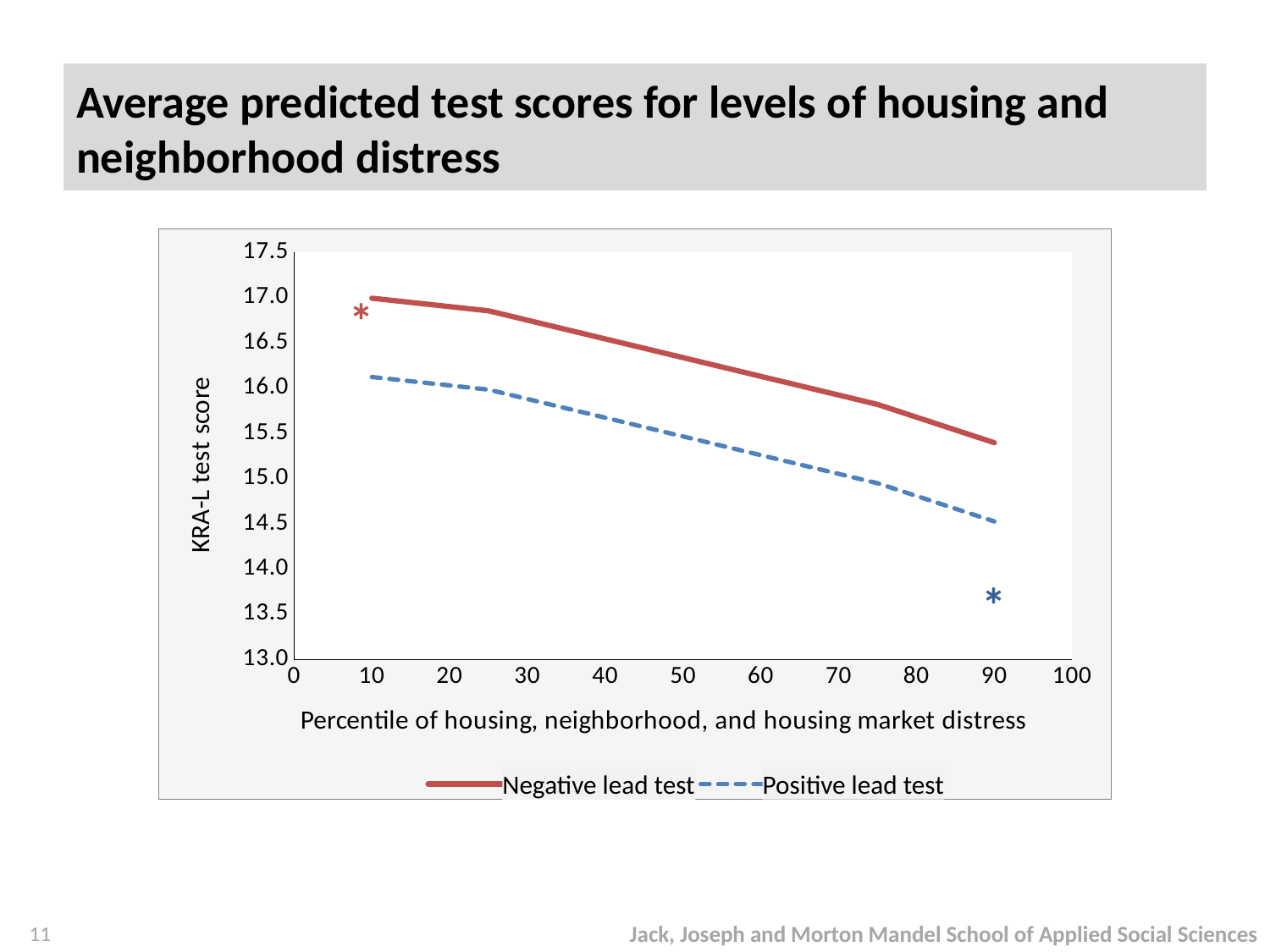
How many series does the legend list? 2 Is the value for Positive lead test at the 90th percentile greater or less than 15.0? less Do the predicted test scores rise or fall as the percentile of distress increases? fall What is the label of the y axis? KRA-L test score What kind of chart is shown on the slide? line chart Is the value for Positive lead test at the 10th percentile greater or less than 15.5? greater Is the value for Negative lead test at the 10th percentile greater or less than 16.5? greater At the 10th percentile, which series has the lower test score, Negative lead test or Positive lead test? Positive lead test At the 90th percentile, which series has the higher test score, Negative lead test or Positive lead test? Negative lead test Which series is drawn with a dashed line? Positive lead test